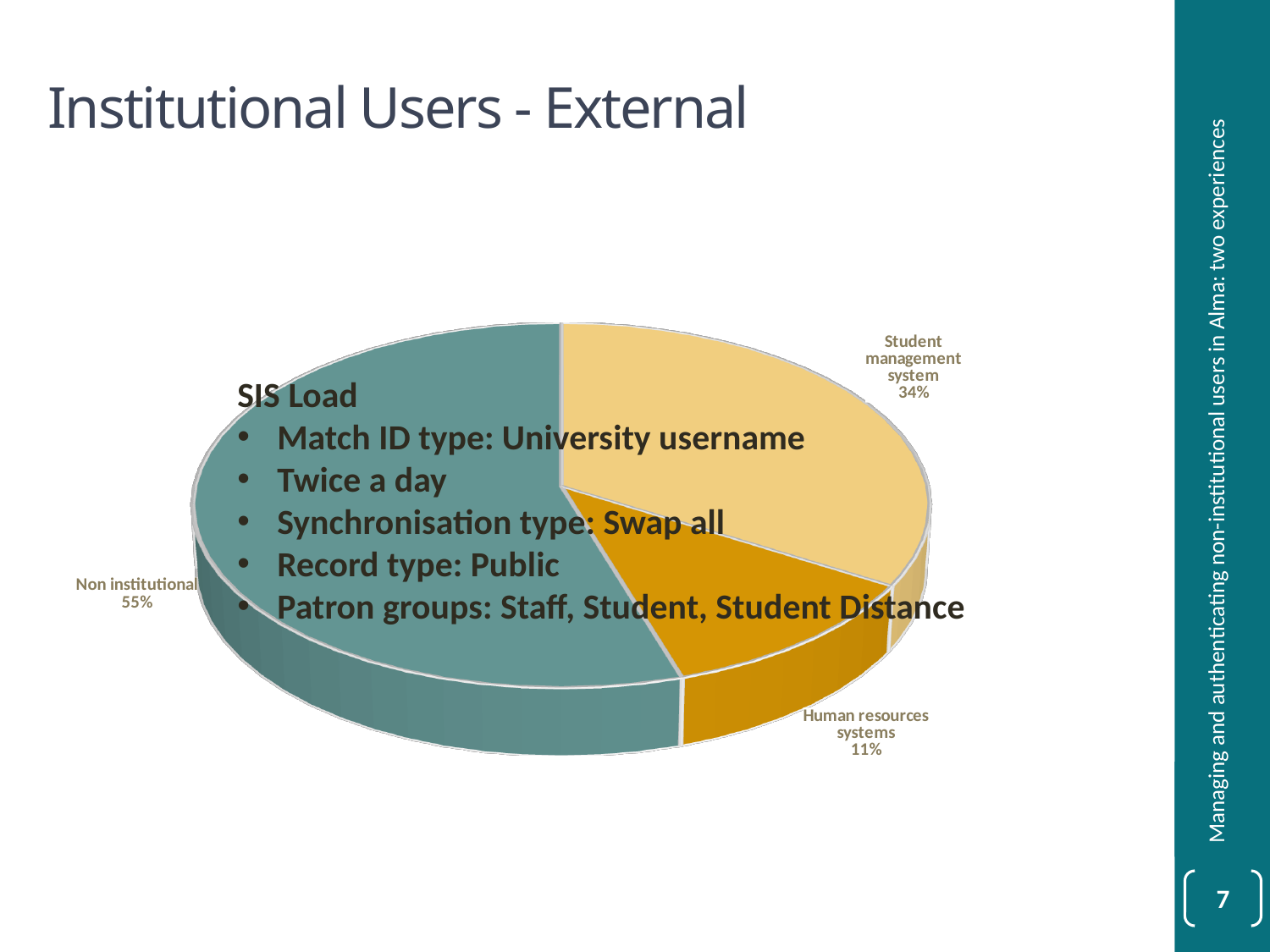
Which slice of the pie is the largest? Non institutional What share of the pie does Human resources systems represent? 11% What share of the pie does Student management system represent? 34% Which is larger, the Student management system slice or the Human resources systems slice? Student management system What share of the pie does Non institutional represent? 55% How many slices does the pie chart have? 3 What is the difference in percentage points between Non institutional and Student management system? 21 What is the difference in percentage points between Student management system and Human resources systems? 23 What colour is the Non institutional slice of the pie? teal What kind of chart is shown on the slide? pie chart Is the share for Non institutional greater or less than 50%? greater Which slice of the pie is the smallest? Human resources systems